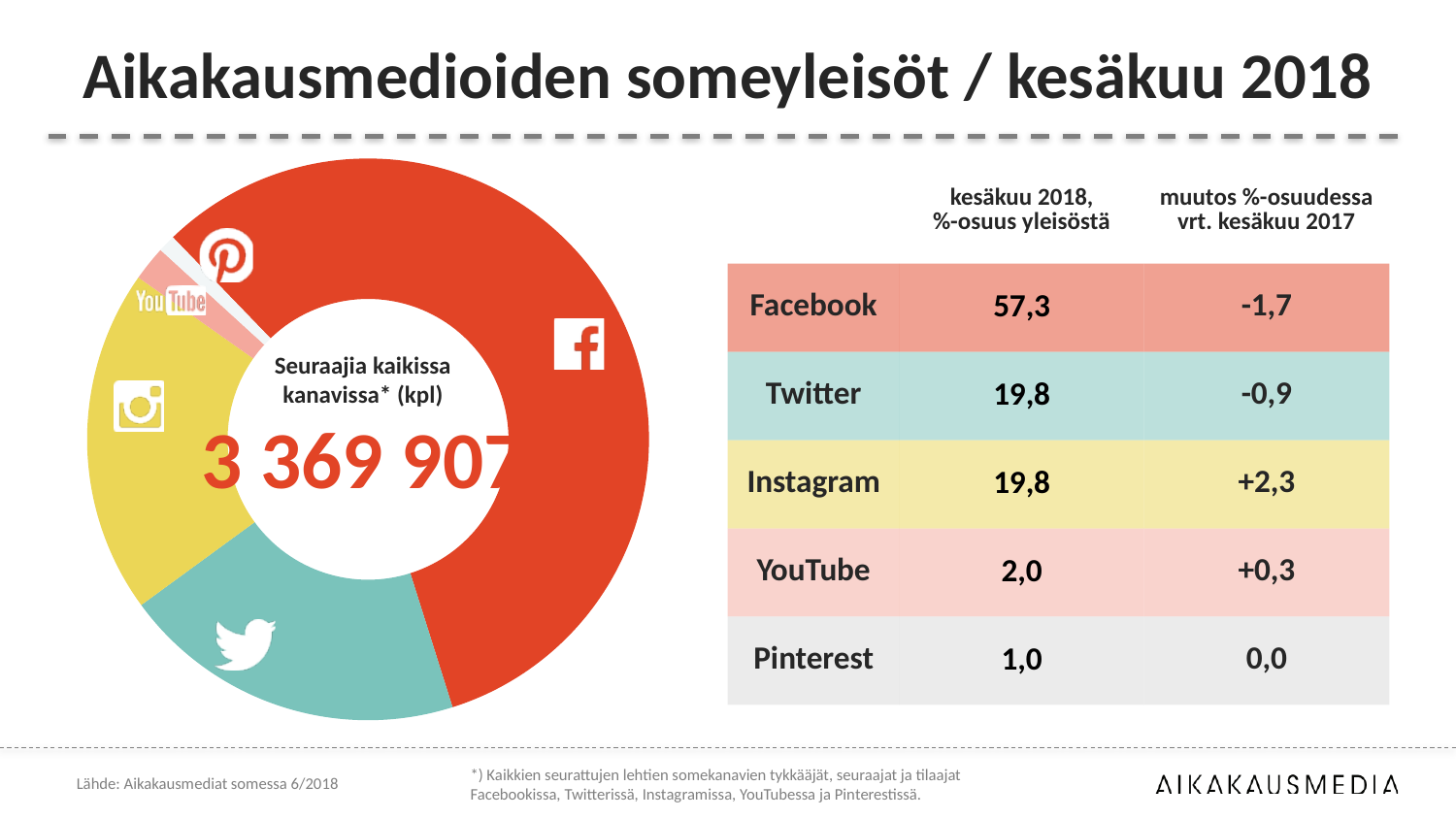
Which has a larger share of the audience, Facebook or Twitter? Facebook What kind of chart is shown on the left of the slide? pie chart (donut) What is Facebook's share of the audience in June 2018 according to the table? 57,3 Which social media channel has the largest slice of the donut chart? Facebook What total number of followers across all channels is printed in the centre of the donut chart? 3 369 907 How many slices does the donut chart have? 5 What is YouTube's share of the audience in June 2018 according to the table? 2,0 What is the change in Instagram's percentage share compared with June 2017? +2,3 What is the title of the slide? Aikakausmedioiden someyleisöt / kesäkuu 2018 What is the change in Facebook's percentage share compared with June 2017? -1,7 Which social media channel has the smallest slice of the donut chart? Pinterest What is the difference in percentage share between Facebook (57,3) and Twitter (19,8)? 37,5